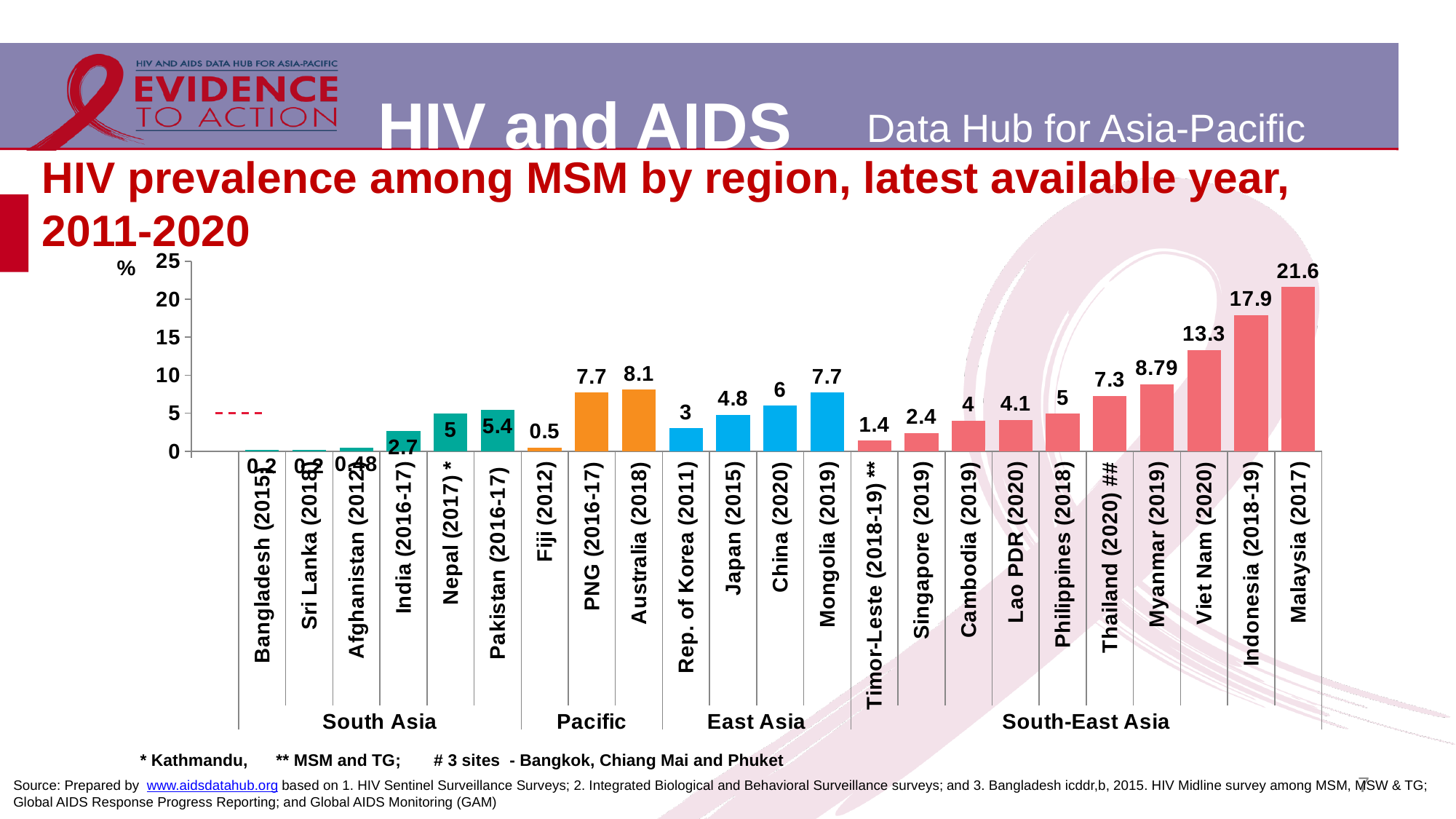
How many countries are plotted on the chart? 23 Within the South-East Asia group, do the values rise or fall from left to right? rise Which has a higher value, Australia (2018) or PNG (2016-17)? Australia (2018) What kind of chart is shown on the slide? bar chart Is the value for Viet Nam (2020) greater or less than 10? greater How many regions are the countries grouped into along the x axis? 4 What is the value shown for Myanmar (2019)? 8.79 What is the HIV prevalence among MSM shown for Malaysia (2017)? 21.6 What is the difference between the values for Malaysia (2017) and Indonesia (2018-19)? 3.7 Which country has the highest HIV prevalence among MSM on the chart? Malaysia (2017) What is the difference between the values for Indonesia (2018-19) and Viet Nam (2020)? 4.6 What is the value shown for Afghanistan (2012)? 0.48